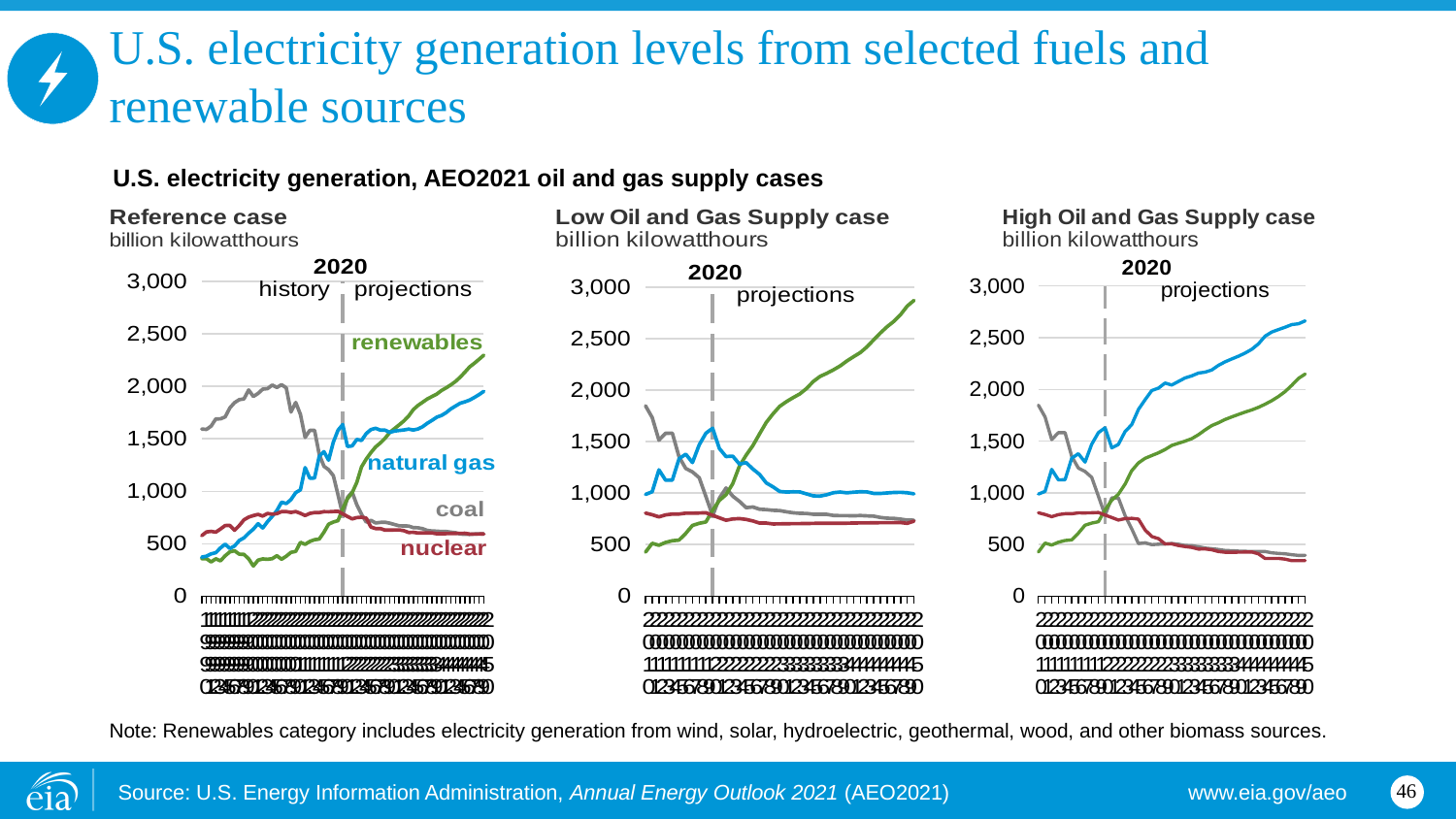
In the High Oil and Gas Supply case chart, is the blue line at the end of the projections greater or less than 2,500? greater In the Reference case chart, is the value for natural gas at the end of the projections greater or less than 1,500? greater What kind of chart is used in the Reference case panel? line chart In the Reference case chart, is the value for renewables at the end of the projections greater or less than 2,000? greater In the Reference case chart, which series is highest at the end of the projection period? renewables In the Low Oil and Gas Supply case chart, which is larger at the end of the projections, the green line or the blue line? the green line In the Reference case chart, which series is highest at the start of the history period? coal In the Reference case chart, does coal rise or fall over the projection period? fall What unit is used on the y axis of the three charts? billion kilowatthours How many charts are shown on the slide? 3